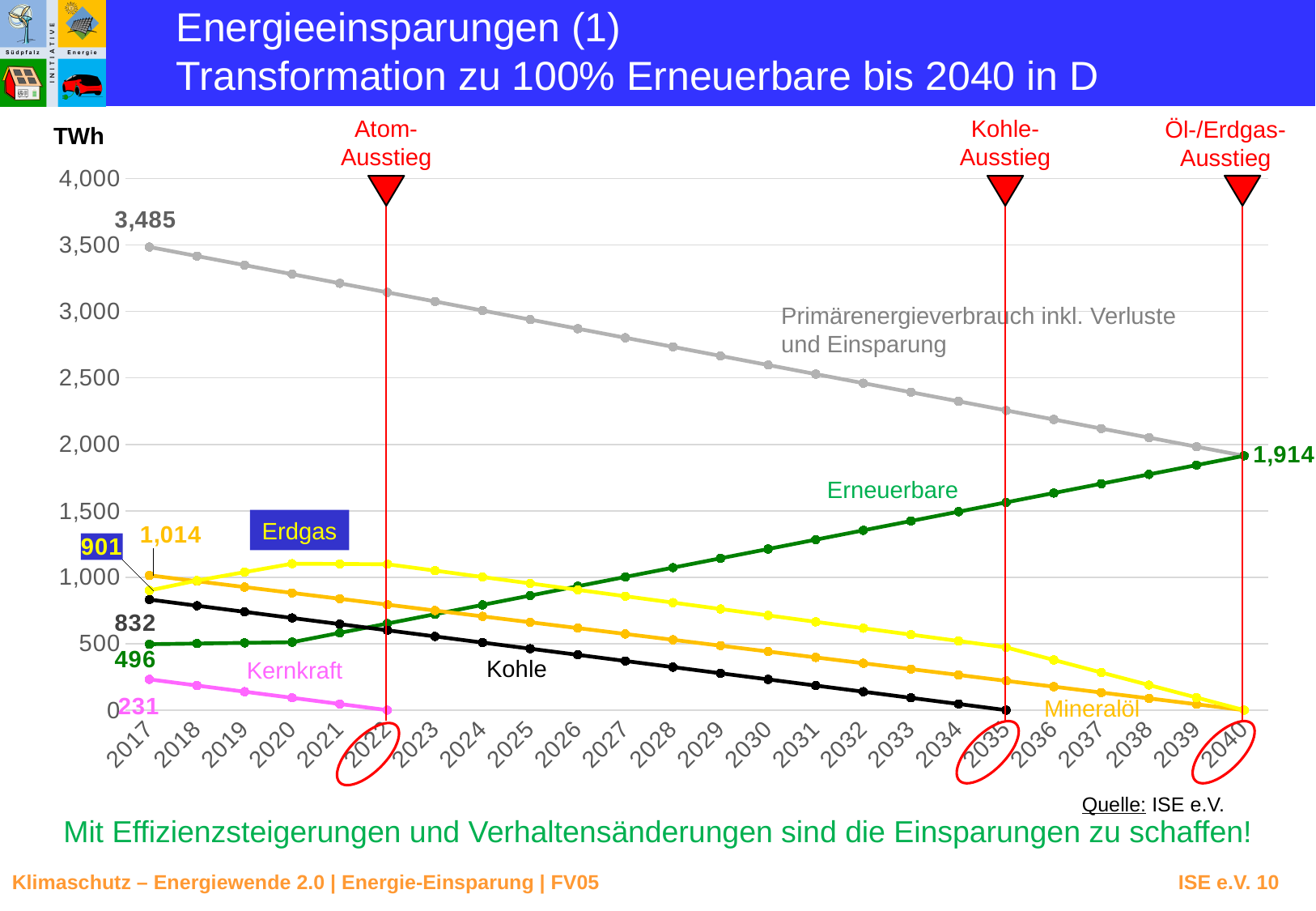
How many years are shown on the x axis? 24 What kind of chart is shown on the slide? line chart What is the value for Mineralöl in 2017? 1,014 Is the value for Kohle in 2035 greater or less than 500? less What is the value for Kernkraft in 2017? 231 What value does the Erneuerbare line reach in 2040? 1,914 What is the value of Primärenergieverbrauch inkl. Verluste und Einsparung in 2017? 3,485 Does the Primärenergieverbrauch line rise or fall from 2017 to 2040? fall In 2017, which is larger: Mineralöl or Erdgas? Mineralöl What is the value for Erdgas in 2017? 901 By how much does the Erneuerbare value increase from 2017 to 2040? 1,418 What is the value for Kohle in 2017? 832